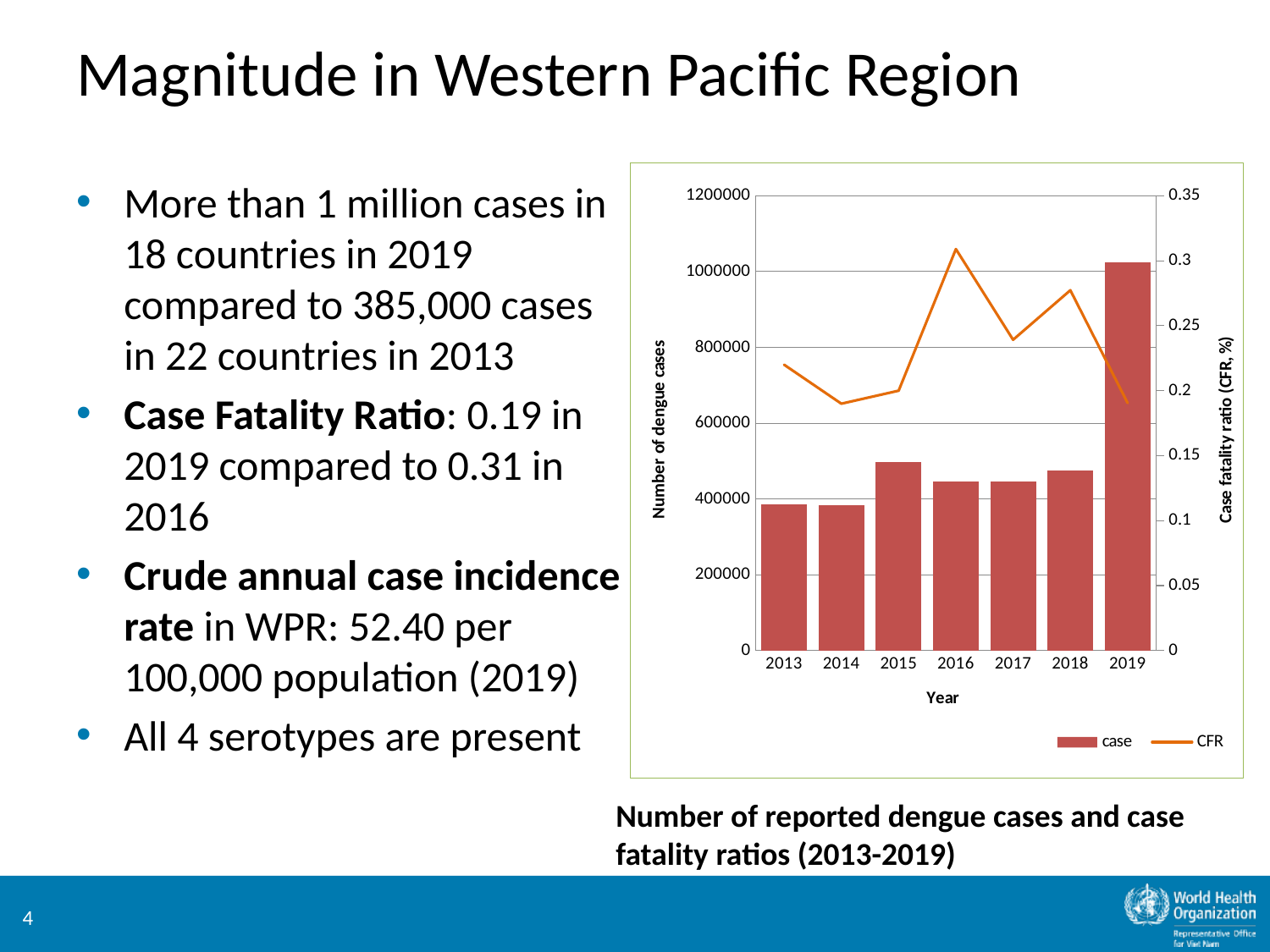
Is the CFR value for 2016 greater or less than 0.3? greater How many years are shown on the x axis of the chart? 7 What are the two entries in the chart legend? case and CFR Is the CFR value for 2019 greater or less than 0.2? less Which year has the highest case fatality ratio (CFR)? 2016 Is the number of dengue cases in 2015 greater or less than 400000? greater Which year has more dengue cases, 2015 or 2016? 2015 Which year has the highest number of dengue cases? 2019 What kind of chart is used to show the number of dengue cases? bar chart How many series does the chart legend list? 2 Do the number of dengue cases rise or fall overall from 2013 to 2019? rise